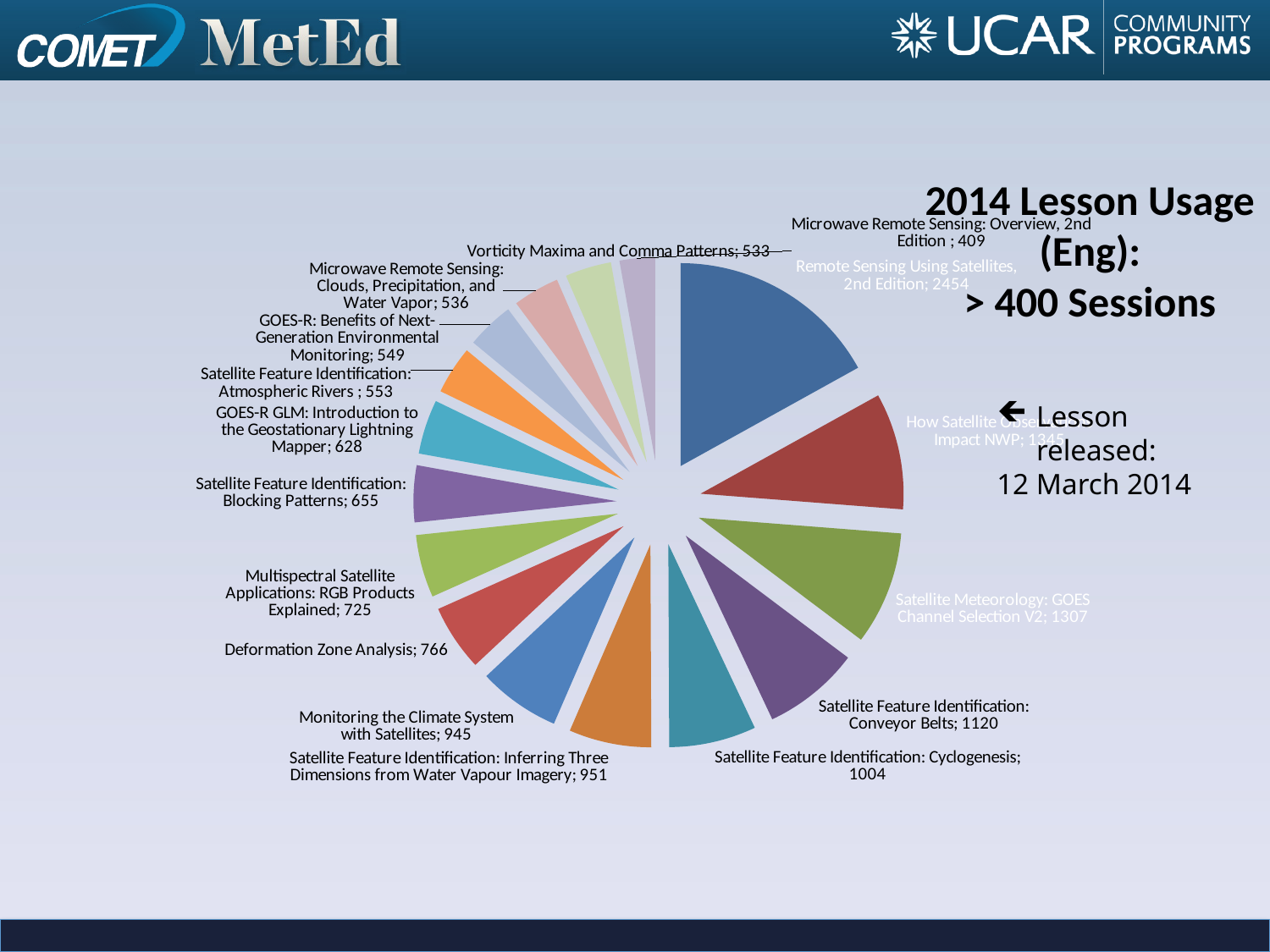
Which lesson has the largest slice in the 2014 Lesson Usage pie chart? Remote Sensing Using Satellites, 2nd Edition What is the value shown for Deformation Zone Analysis? 766 Which lesson has the smallest slice in the pie chart? Microwave Remote Sensing: Overview, 2nd Edition What is the value shown for GOES-R GLM: Introduction to the Geostationary Lightning Mapper? 628 What is the value shown for Remote Sensing Using Satellites, 2nd Edition? 2454 What is the value shown for Vorticity Maxima and Comma Patterns? 533 Which has a larger value: Monitoring the Climate System with Satellites or Multispectral Satellite Applications: RGB Products Explained? Monitoring the Climate System with Satellites What is the value shown for Satellite Feature Identification: Conveyor Belts? 1120 What kind of chart is shown on the slide? pie chart How many lessons (slices) are shown in the pie chart? 16 What is the title of the pie chart? 2014 Lesson Usage (Eng): > 400 Sessions What is the difference between the values for Satellite Meteorology: GOES Channel Selection V2 and Satellite Feature Identification: Cyclogenesis? 303